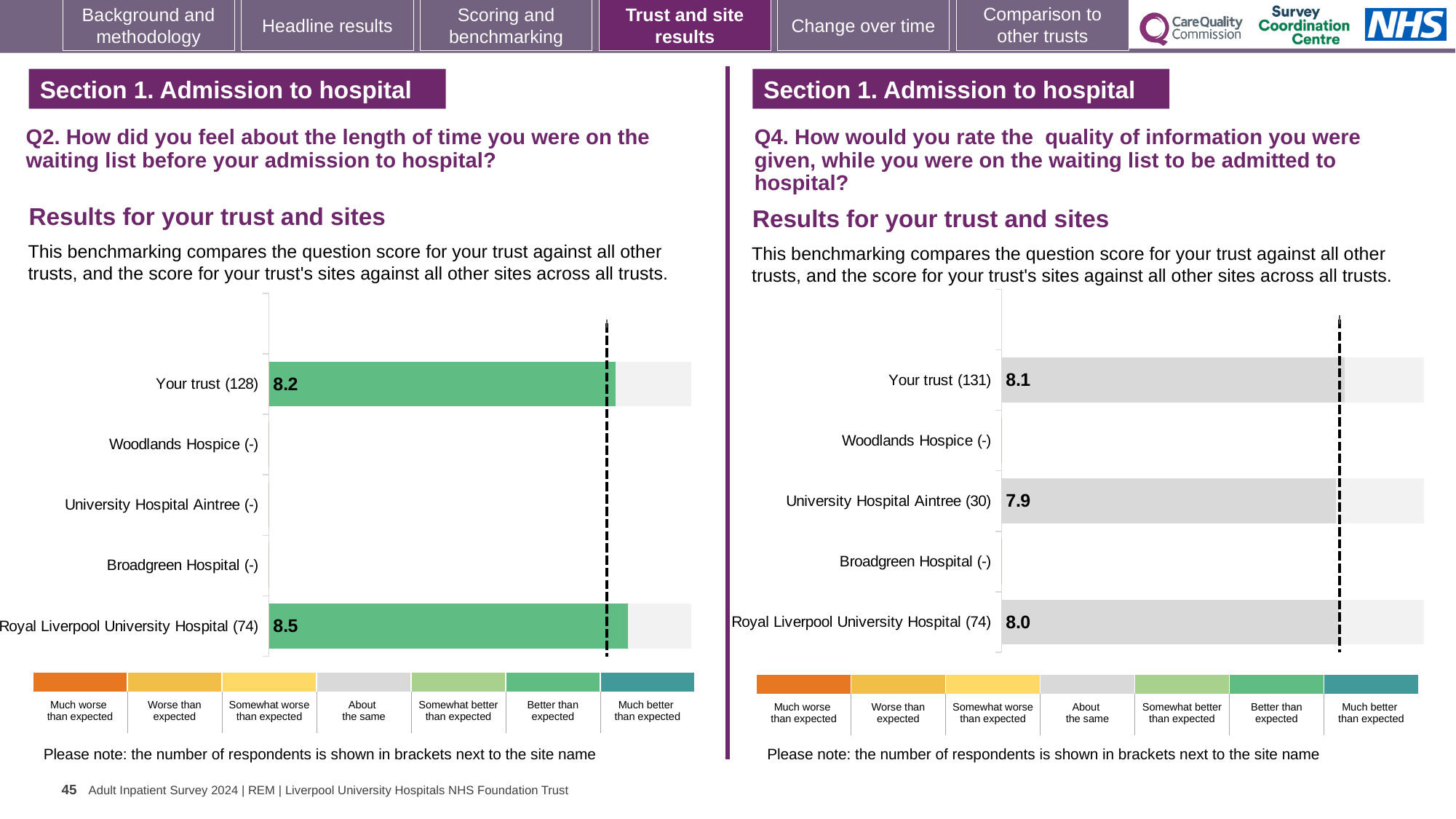
In the Q4 chart on the right, what is the difference between the scores for Your trust and University Hospital Aintree? 0.2 In the Q4 chart on the right, what is the score for Royal Liverpool University Hospital (74)? 8.0 In the Q4 chart on the right, what is the score for University Hospital Aintree (30)? 7.9 In the Q4 chart on the right, which site or trust has the lowest score shown? University Hospital Aintree In the Q2 chart on the left, what is the difference between the scores for Royal Liverpool University Hospital and Your trust? 0.3 How many site or trust categories are listed on the y axis of the Q2 chart on the left? 5 In the Q4 chart on the right, what is the score for Your trust (131)? 8.1 In the Q2 chart on the left, which has the higher score: Your trust or Royal Liverpool University Hospital? Royal Liverpool University Hospital In the Q2 chart on the left, what is the score for Your trust (128)? 8.2 In the Q2 chart on the left, what is the score for Royal Liverpool University Hospital (74)? 8.5 What kind of chart is the Q4 chart on the right? Bar chart In the Q2 chart on the left, which benchmark category does the green colour of the bars correspond to in the legend? Better than expected